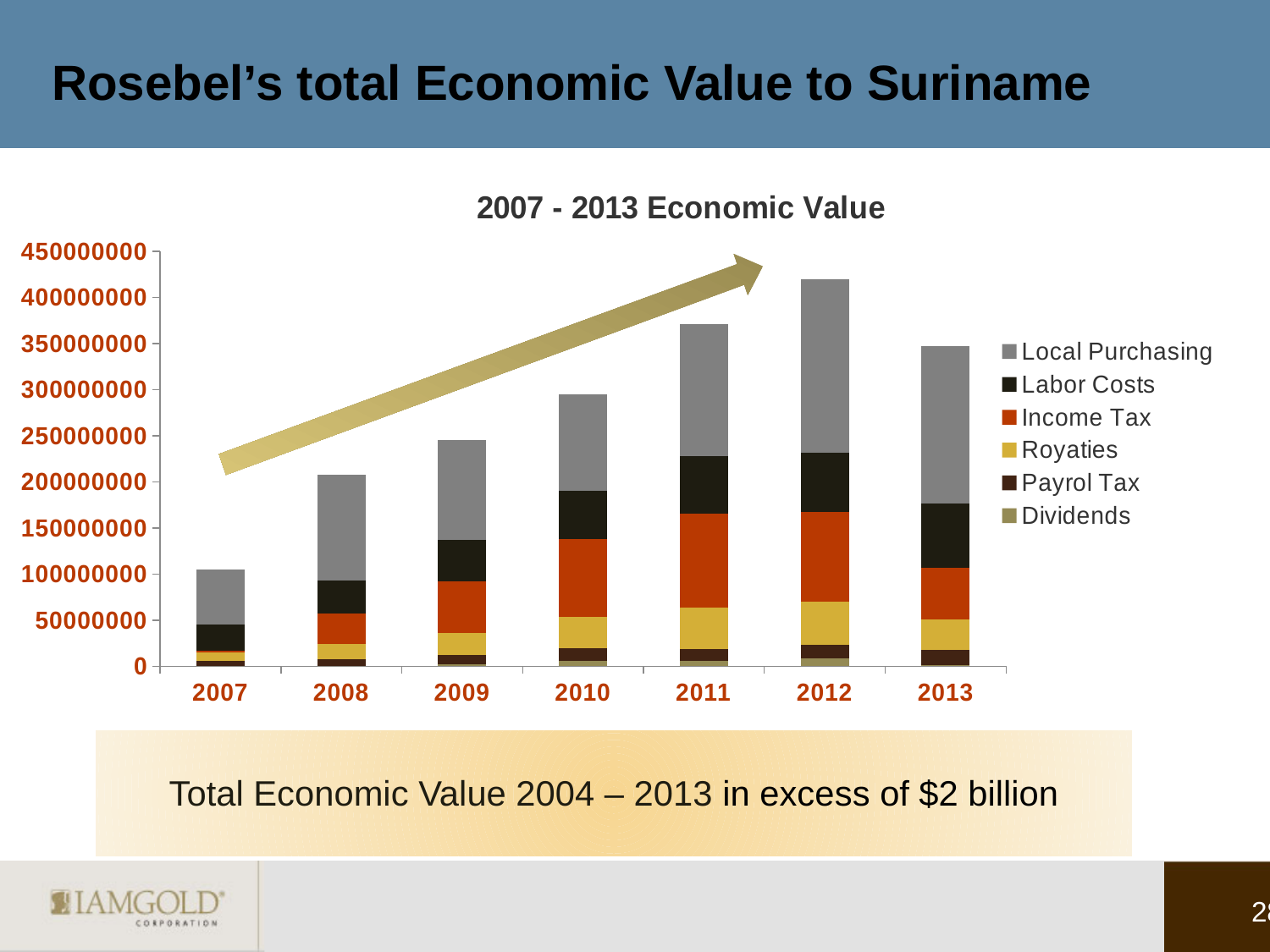
Is the total value for 2011 greater or less than 350000000? greater Which series is shown by the grey segment at the top of each bar? Local Purchasing Is the total value for 2012 greater or less than 400000000? greater What kind of chart is shown on the slide? Stacked bar chart Which year has a larger total economic value, 2012 or 2013? 2012 Is the total value for 2007 greater or less than 150000000? less How many years are shown on the x axis? 7 Which year has the highest total economic value? 2012 How many series does the legend list? 6 What is the title of the chart? 2007 - 2013 Economic Value Which year has the lowest total economic value? 2007